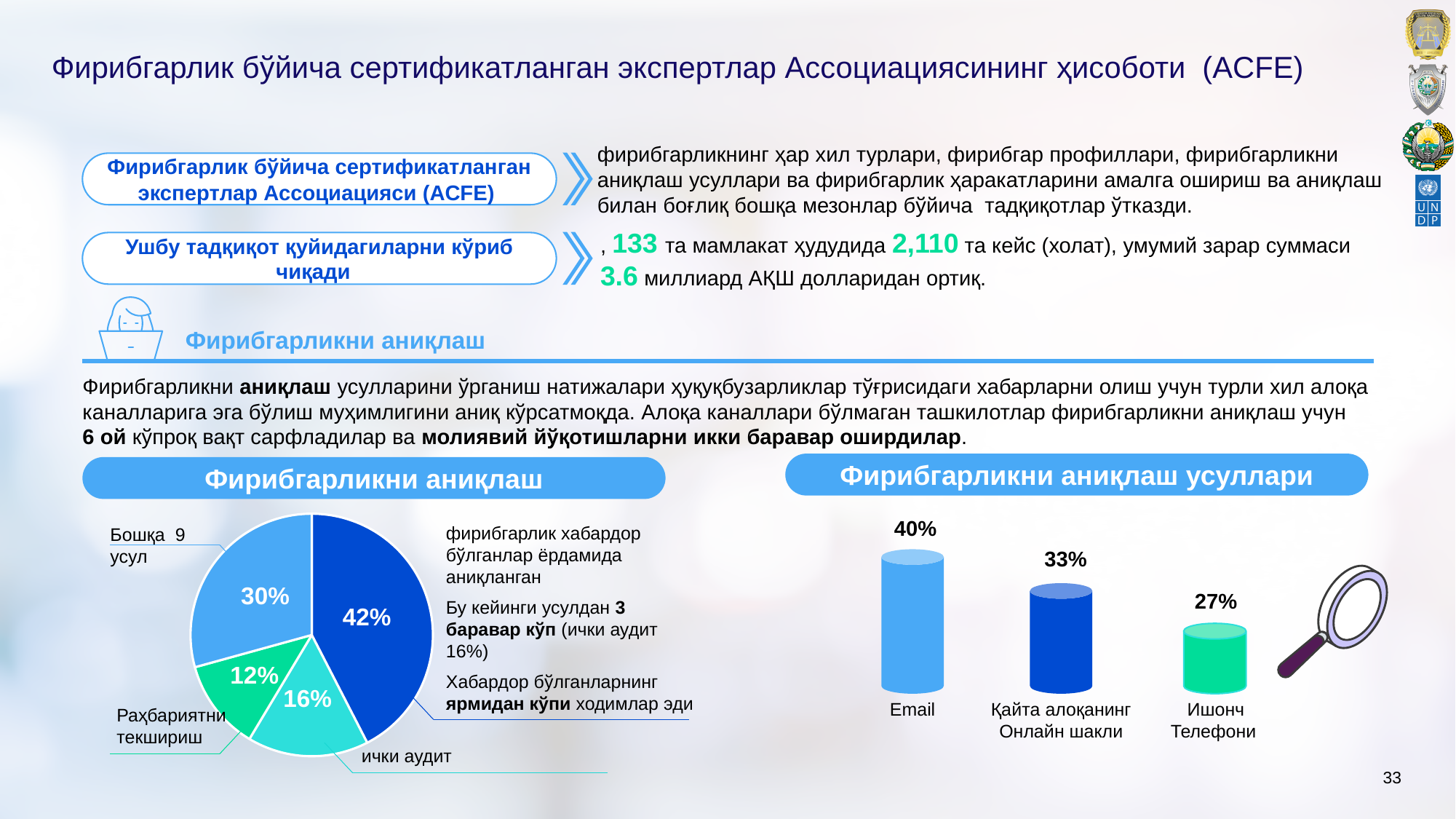
In the bar chart 'Фирибгарликни аниқлаш усуллари', which category has the highest value? Email In the bar chart 'Фирибгарликни аниқлаш усуллари', what is the value for Ишонч Телефони? 27% In the pie chart 'Фирибгарликни аниқлаш', which is larger: Бошқа 9 усул or ички аудит? Бошқа 9 усул In the pie chart 'Фирибгарликни аниқлаш', how many slices are there? 4 In the bar chart 'Фирибгарликни аниқлаш усуллари', which category has the lowest value? Ишонч Телефони In the bar chart 'Фирибгарликни аниқлаш усуллари', what is the difference between Email and Қайта алоқанинг Онлайн шакли? 7% What kind of chart is 'Фирибгарликни аниқлаш усуллари'? Bar chart In the bar chart 'Фирибгарликни аниқлаш усуллари', what is the value for Email? 40% In the pie chart 'Фирибгарликни аниқлаш', what share is labelled for Раҳбариятни текшириш? 12% In the pie chart 'Фирибгарликни аниқлаш', what is the largest slice's value? 42% In the bar chart 'Фирибгарликни аниқлаш усуллари', how many categories are shown? 3 In the pie chart 'Фирибгарликни аниқлаш', what share is labelled for ички аудит? 16%